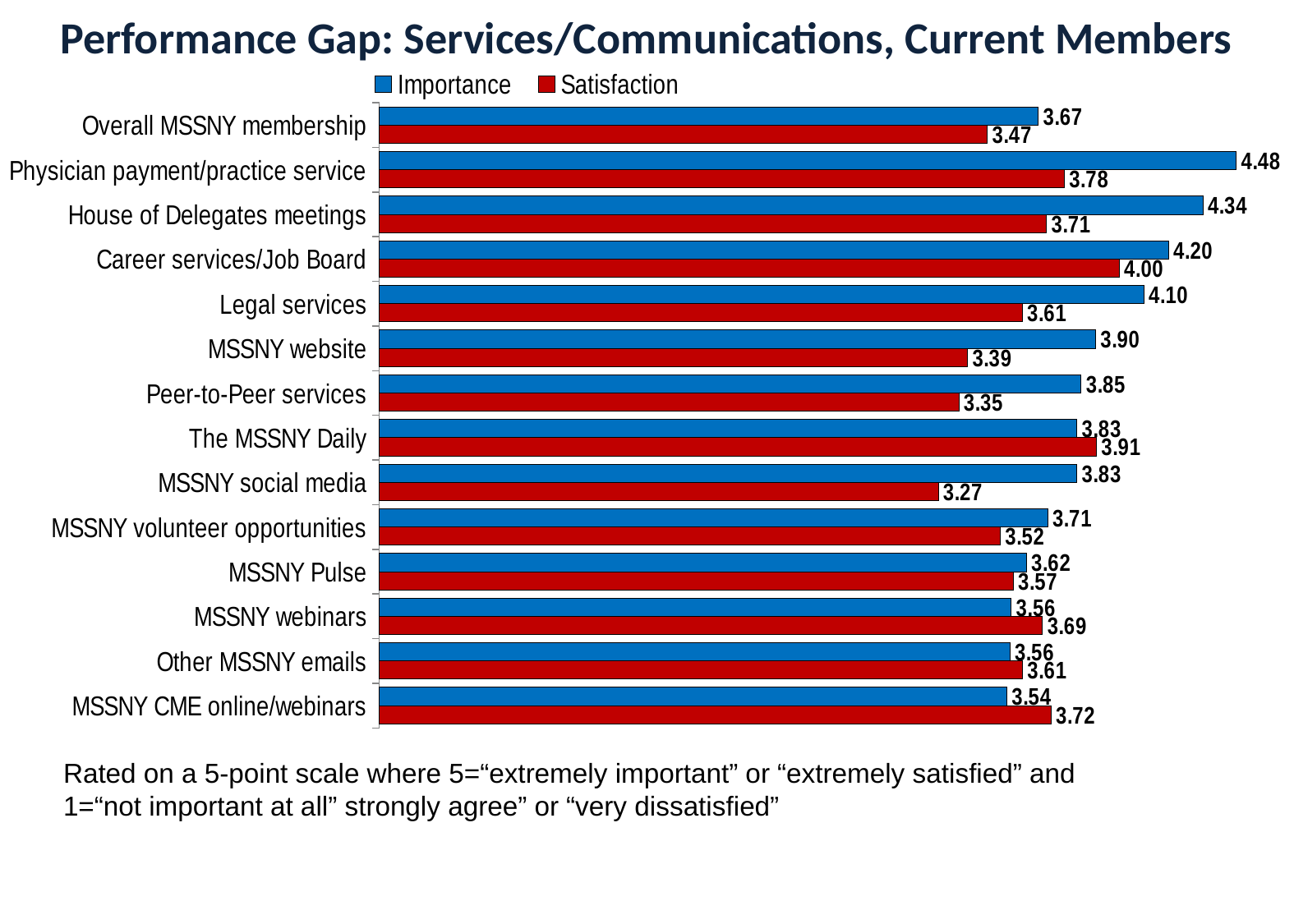
How many series does the legend list? 2 Which category has the lowest Satisfaction value? MSSNY social media What is the Satisfaction value for Career services/Job Board? 4.00 Is the Importance value for House of Delegates meetings greater or less than 4.00? greater For The MSSNY Daily, which is larger: Importance or Satisfaction? Satisfaction What is the Importance value for Physician payment/practice service? 4.48 How many categories are shown in the chart? 14 What is the difference between Importance and Satisfaction for Peer-to-Peer services? 0.50 What is the Satisfaction value for MSSNY social media? 3.27 Which category has the highest Importance value? Physician payment/practice service What colour represents the Satisfaction series? Red What kind of chart is shown on the slide? Bar chart